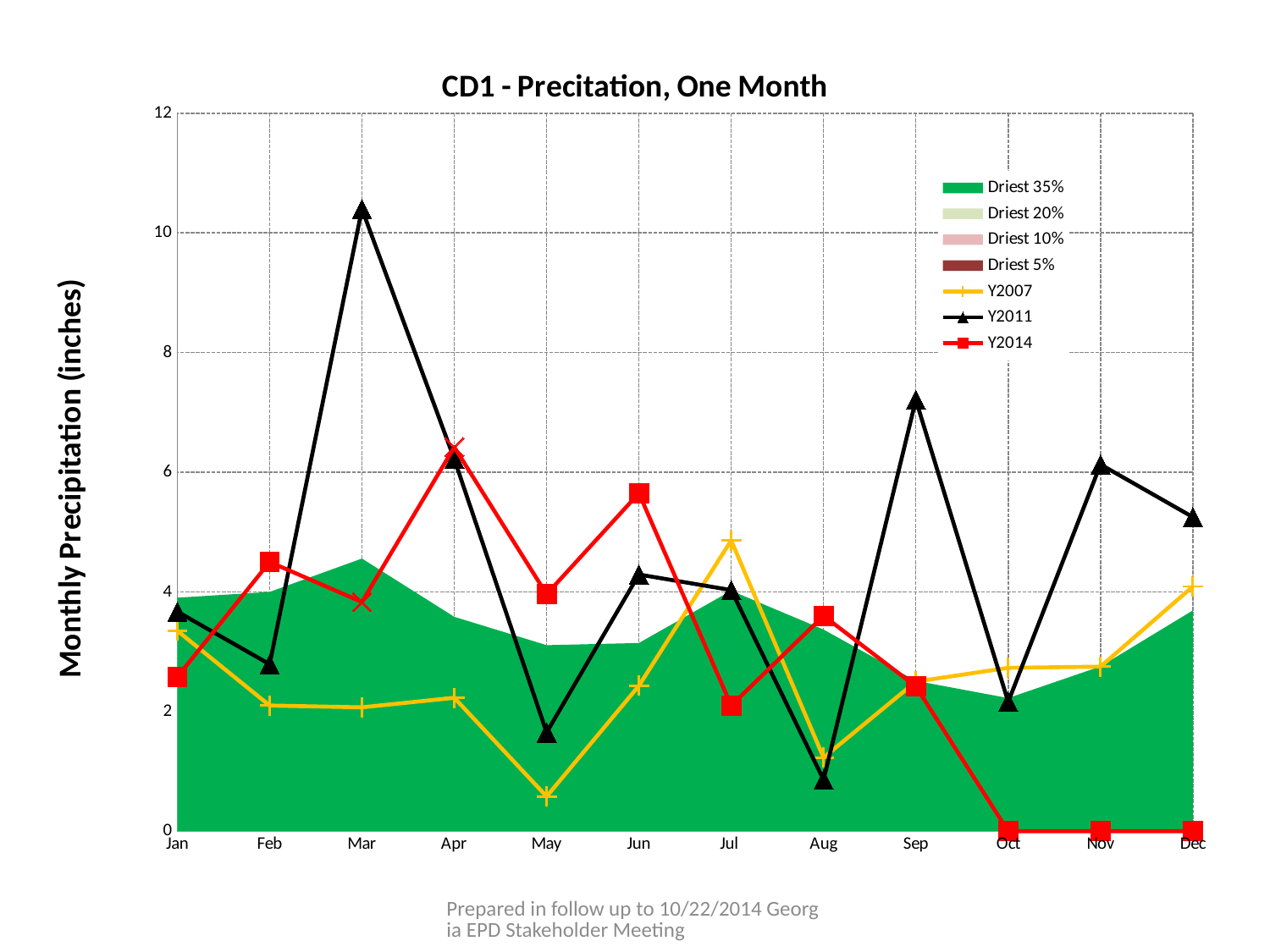
What kind of chart is this? Combination area and line chart In which month does the Y2011 series reach its highest value? Mar In which month does the Y2014 series reach its highest value? Apr Which series has the larger value in Jul, Y2007 or Y2011? Y2007 What is the title of the chart? CD1 - Precitation, One Month What is the label on the vertical axis? Monthly Precipitation (inches) Is the Y2011 value for Mar greater or less than 8? greater Is the Y2014 value for Oct greater or less than 2? less How many months are shown along the x axis? 12 How many series does the legend list? 7 In which month does the Y2007 series reach its lowest value? May Does the Y2014 series rise or fall from Sep to Dec? Fall